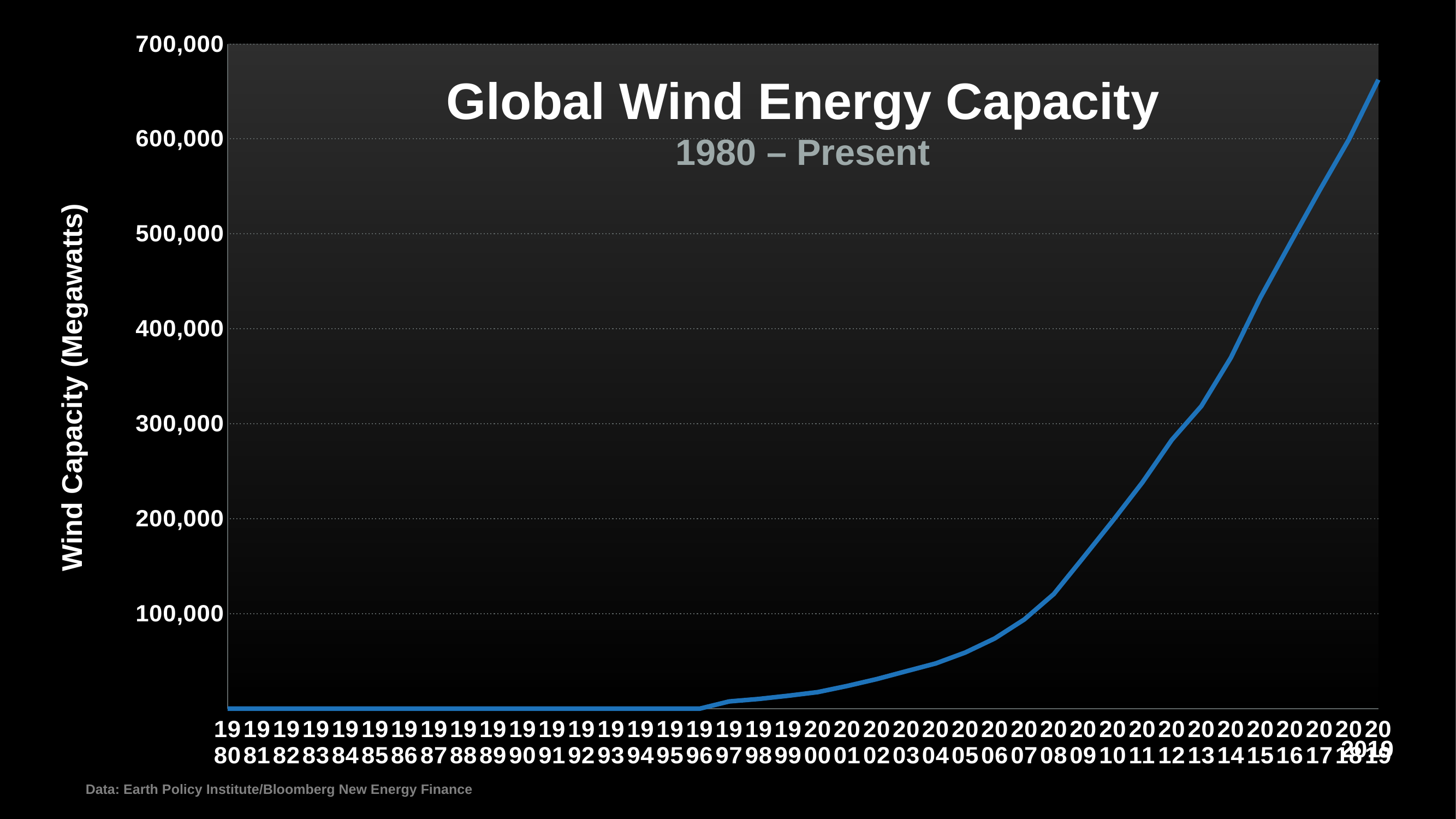
Which year has the larger wind capacity, 2005 or 2015? 2015 Is the wind capacity value for 2017 greater or less than 500,000? greater What kind of chart is shown on the slide? line chart Which year has the highest wind capacity on the chart? 2019 Is the wind capacity value for 2005 greater or less than 100,000? less Does wind capacity rise or fall from 1980 to 2019 along the x axis? rise Which year has the larger wind capacity, 2010 or 2019? 2019 What is the label on the vertical axis of the chart? Wind Capacity (Megawatts) What is the title of the chart? Global Wind Energy Capacity Is the wind capacity value for 2000 greater or less than 100,000? less